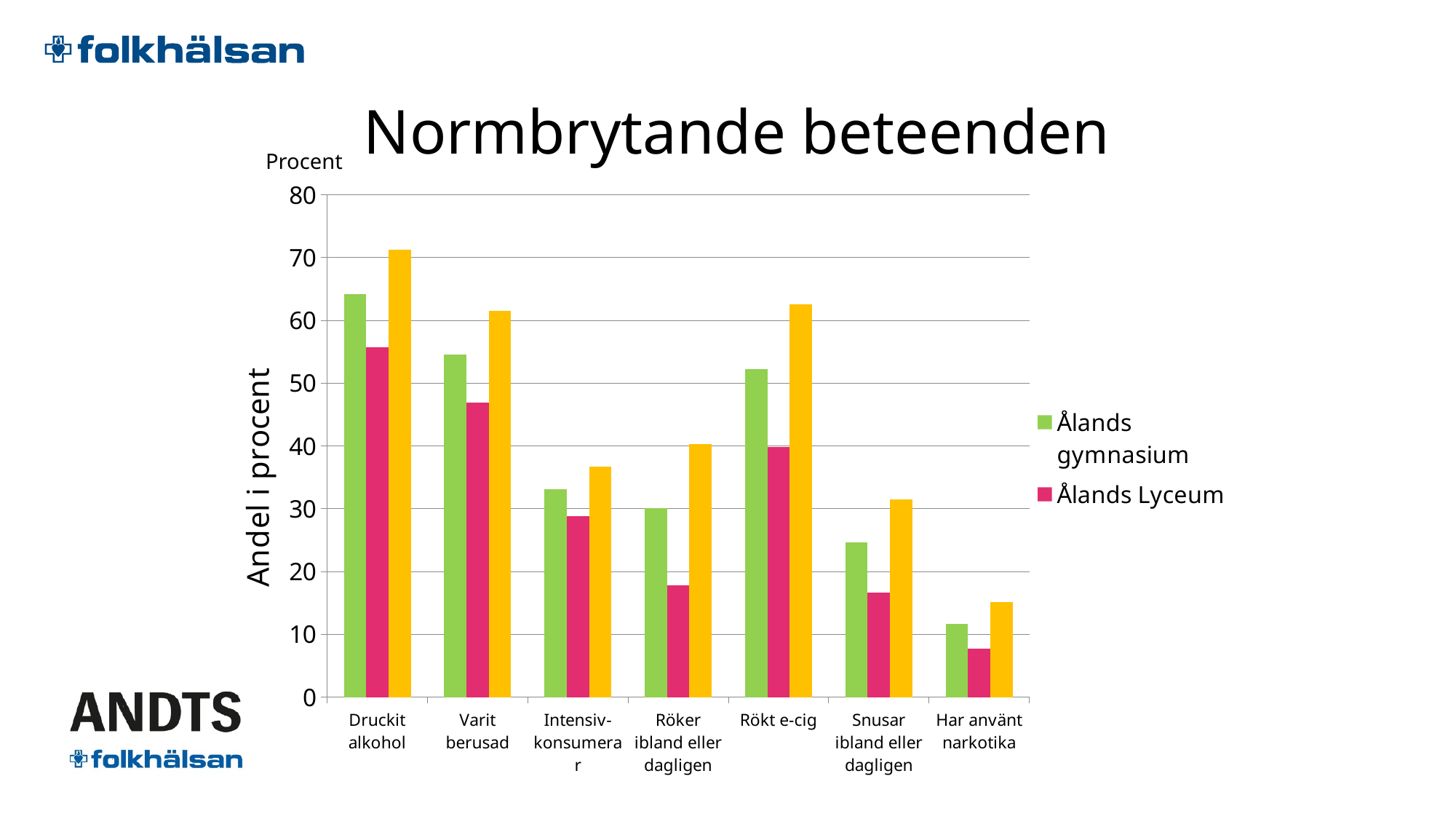
For which category is the Ålands gymnasium value highest? Druckit alkohol Is the Ålands gymnasium value for Druckit alkohol greater or less than 60? greater Is the Ålands gymnasium value for Snusar ibland eller dagligen greater or less than 20? greater What is the title of the chart? Normbrytande beteenden Is the Ålands Lyceum value for Varit berusad greater or less than 50? less For Ålands Lyceum, which is larger, the value for Druckit alkohol or the value for Varit berusad? Druckit alkohol For which category is the Ålands Lyceum value lowest? Har använt narkotika For Rökt e-cig, which series has the larger value, Ålands gymnasium or Ålands Lyceum? Ålands gymnasium What kind of chart is shown on the slide? bar chart How many series does the legend list? 2 How many categories are shown on the x axis of the chart? 7